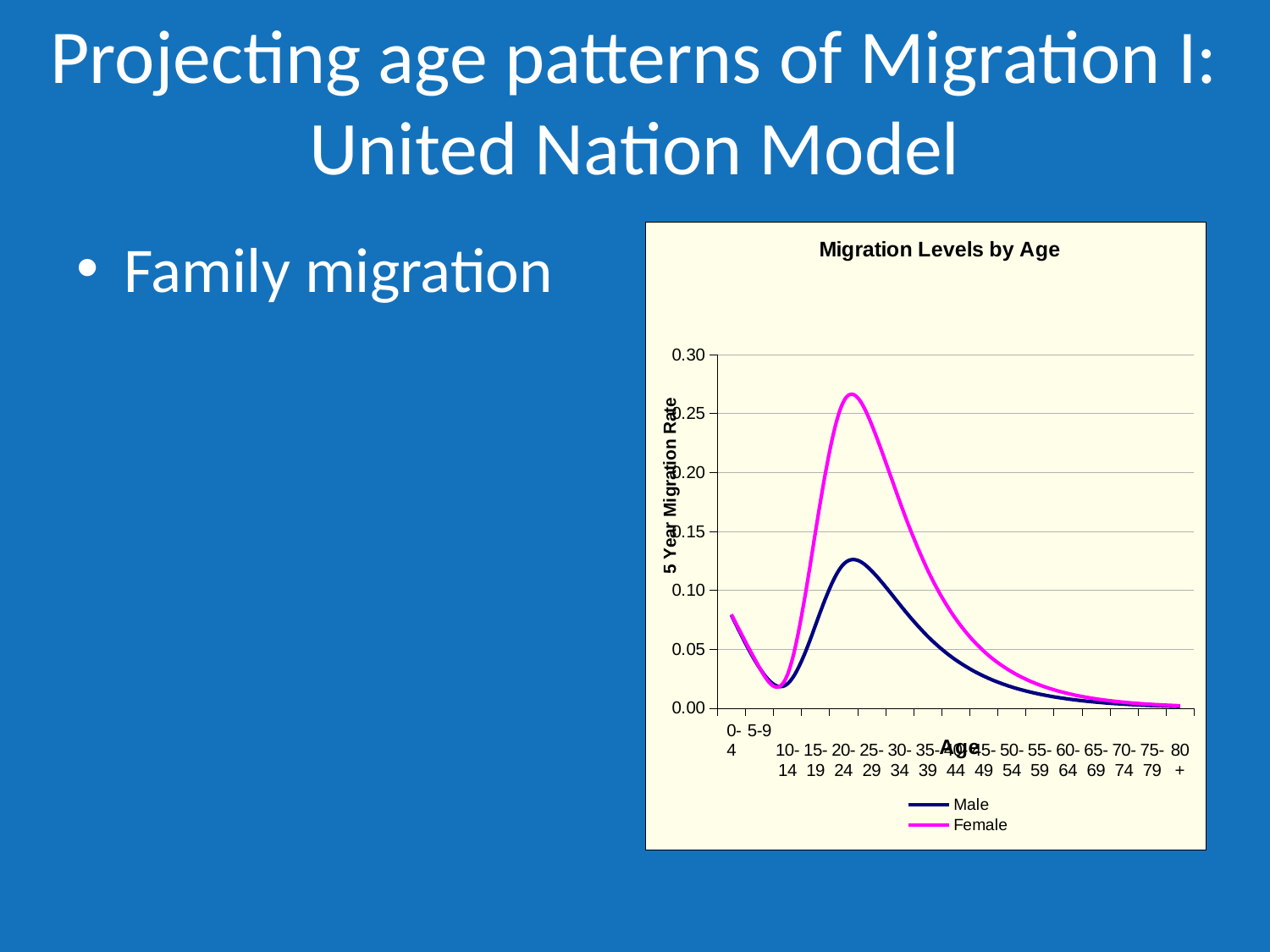
Is the peak value of the Male series greater or less than 0.15? less What type of chart is shown on the slide? Line chart How many series does the chart's legend list? 2 From the 25-29 age group onward, do the migration rates for both series rise or fall with age? fall Is the Female value for the 80+ age group greater or less than 0.05? less How many age groups are shown along the x axis of the chart? 17 Which series reaches the higher peak migration rate, Male or Female? Female Is the Male value for the 0-4 age group greater or less than 0.05? greater What is the title of the chart? Migration Levels by Age What is the label of the vertical axis? 5 Year Migration Rate